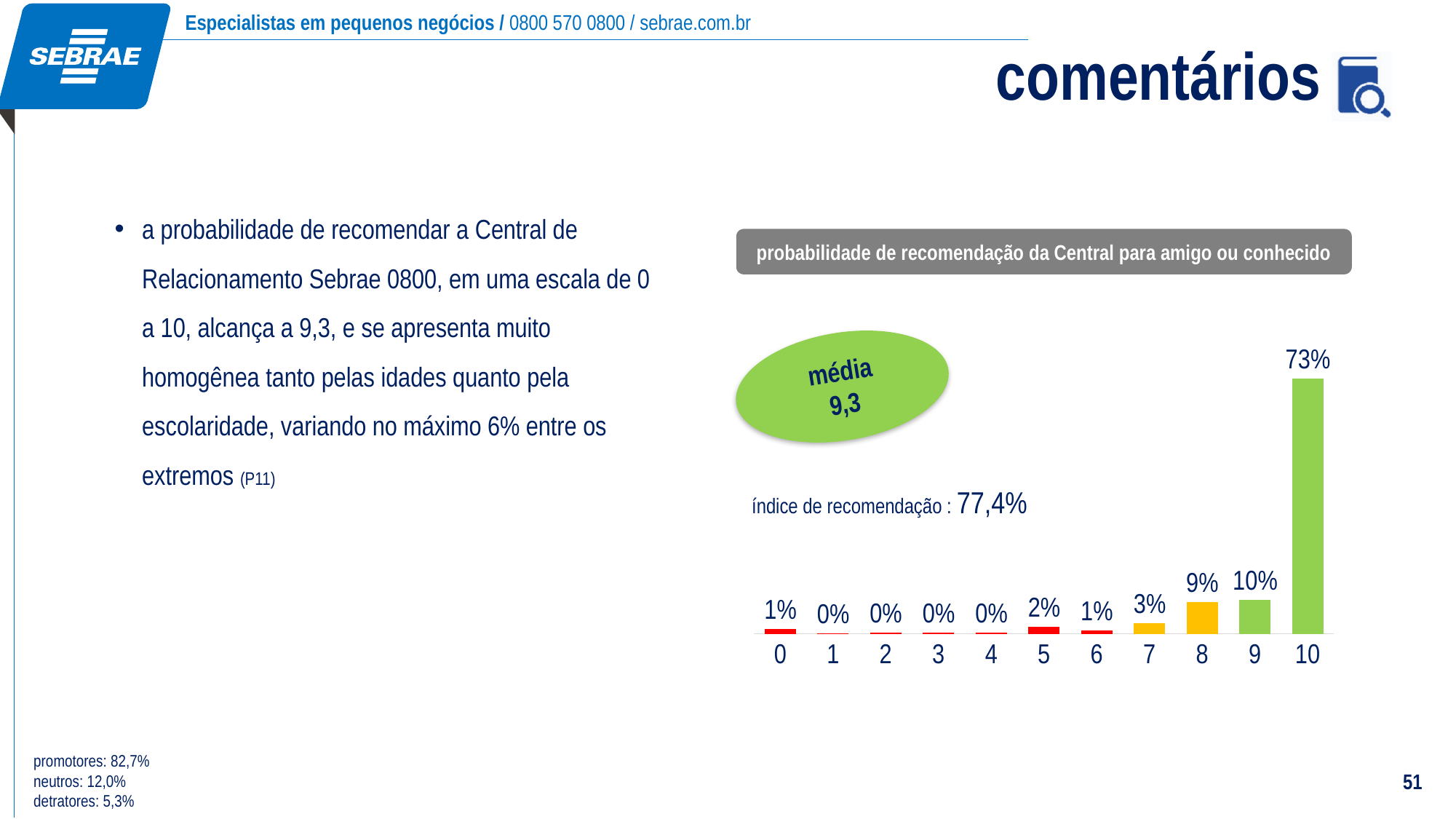
What is the 'média' value shown in the green oval next to the chart? 9,3 What is the title of the chart? probabilidade de recomendação da Central para amigo ou conhecido Which is larger, the value for category 8 or the value for category 7? 8 Which category has the highest value in the chart? 10 What is the difference between the values for categories 10 and 9? 63% What is the value for category 8 in the chart? 9% What kind of chart is shown on the slide? bar chart What is the value for category 5 in the chart? 2% How many categories are shown on the x axis of the chart? 11 What is the value for category 7 in the chart? 3% What is the value for category 9 in the chart? 10% What is the value for category 10 in the chart? 73%